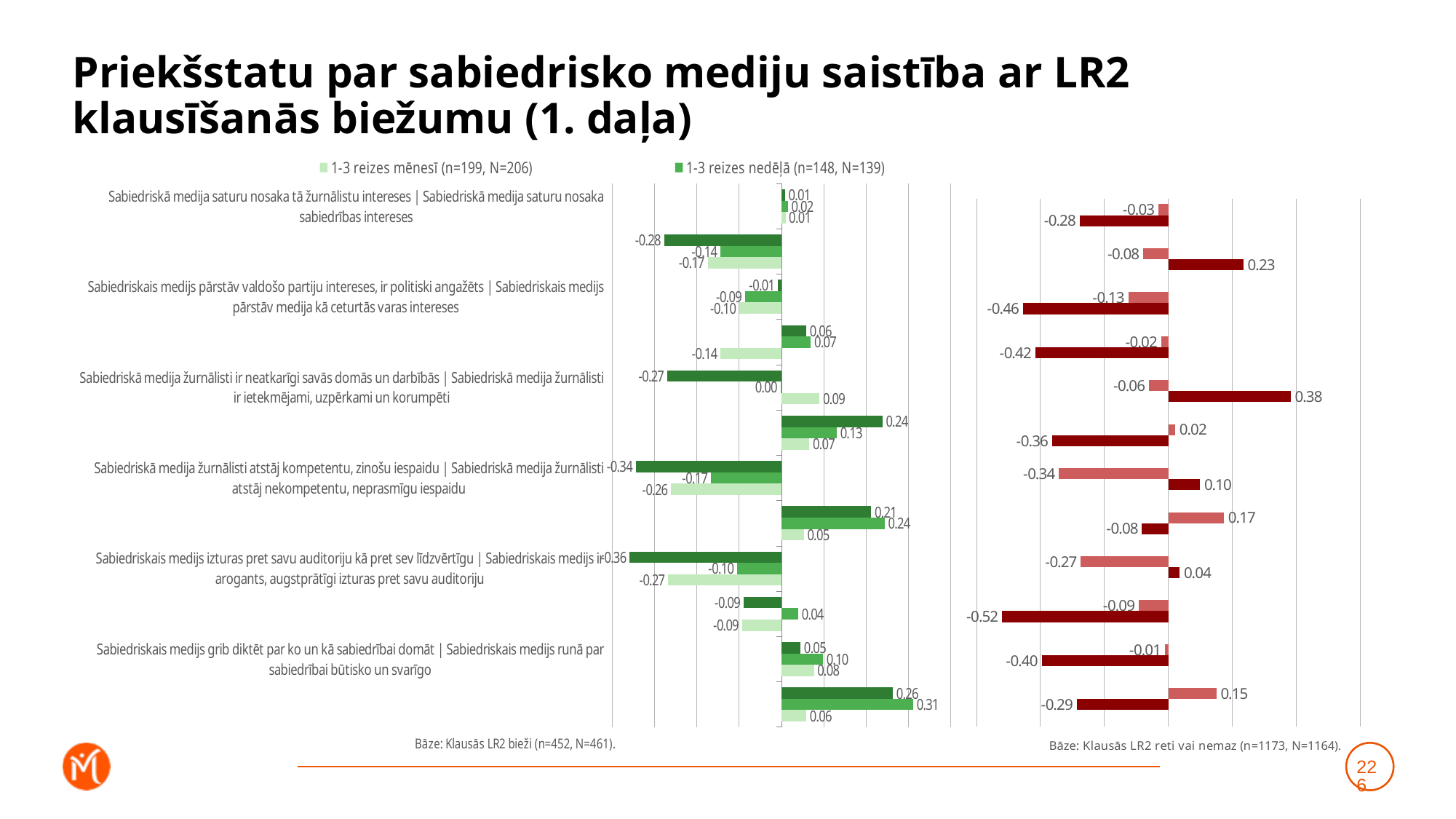
Which is larger: the highest value in the left chart (0.31) or the highest value in the right chart (0.38)? the right chart's 0.38 In the right chart (Bāze: Klausās LR2 reti vai nemaz), what is the highest value shown? 0.38 In the right chart (Bāze: Klausās LR2 reti vai nemaz), what is the lowest value shown? -0.52 In the right chart, what is the value of the dark red bar in the bottom-most group? -0.29 How many category labels are listed along the left side of the charts? 6 What kind of chart is used on this slide? bar chart In the right chart, what is the value of the light red bar in the bottom-most group? 0.15 In the left chart (Bāze: Klausās LR2 bieži), what is the highest value shown? 0.31 In the left chart, what is the value of the light green bar in the bottom-most group? 0.06 What base (Bāze) is stated below the right chart? Klausās LR2 reti vai nemaz (n=1173, N=1164) In the right chart, what is the difference between the highest value (0.38) and the lowest value (-0.52)? 0.90 In the left chart (Bāze: Klausās LR2 bieži), what is the lowest value shown? -0.36